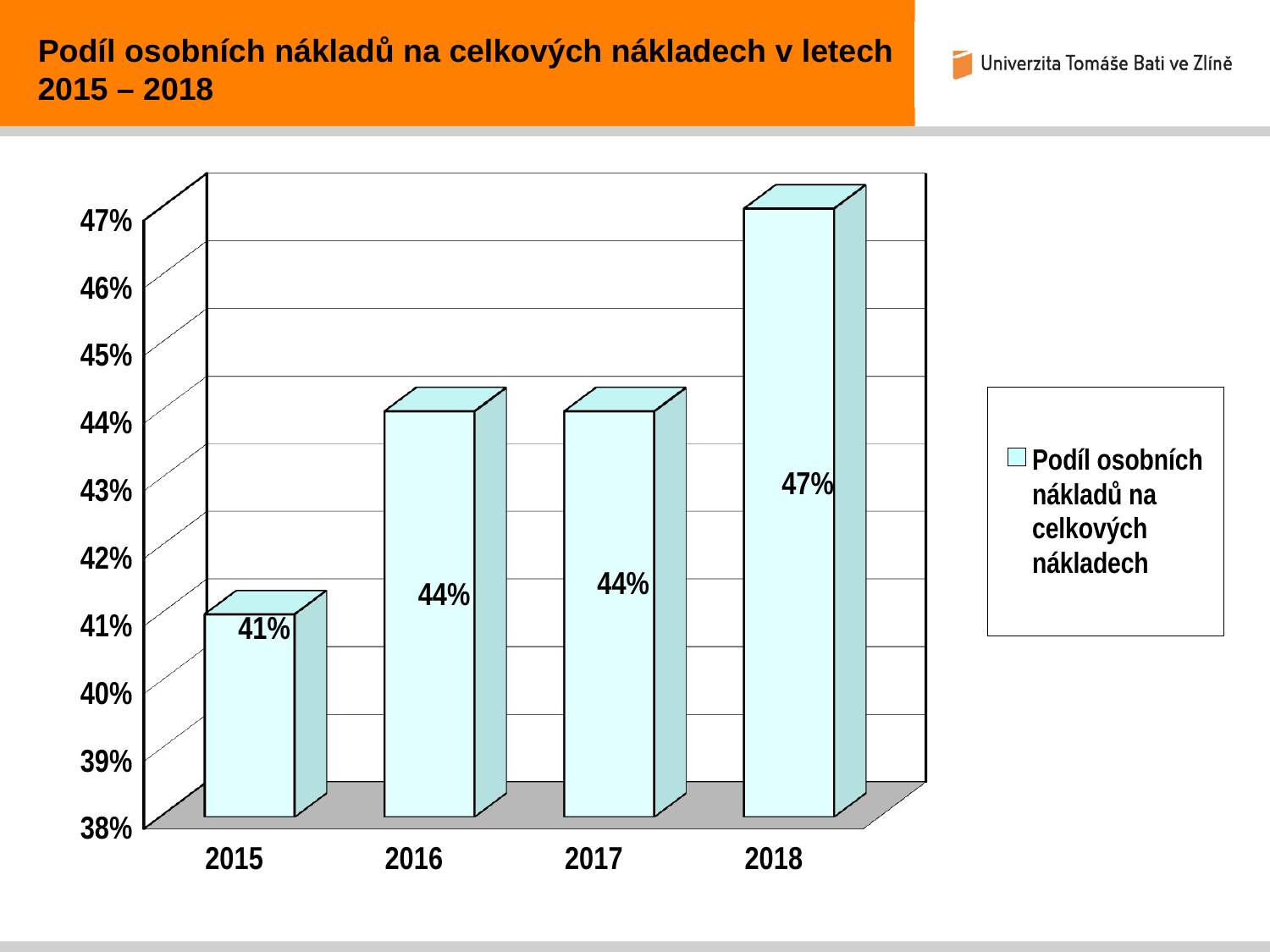
What is the difference between the values for 2018 and 2015? 6% Is the value for 2018 greater or less than 45%? greater What is the difference between the values for 2016 and 2015? 3% Do the values rise or fall from 2015 to 2018? rise What kind of chart is shown on the slide? bar chart Which year has the lowest value? 2015 What is the value for 2015? 41% What is the value for 2018? 47% Which year has the highest value? 2018 Which is larger, the value for 2017 or the value for 2018? 2018 What is the value for 2016? 44% How many years are shown on the x axis? 4